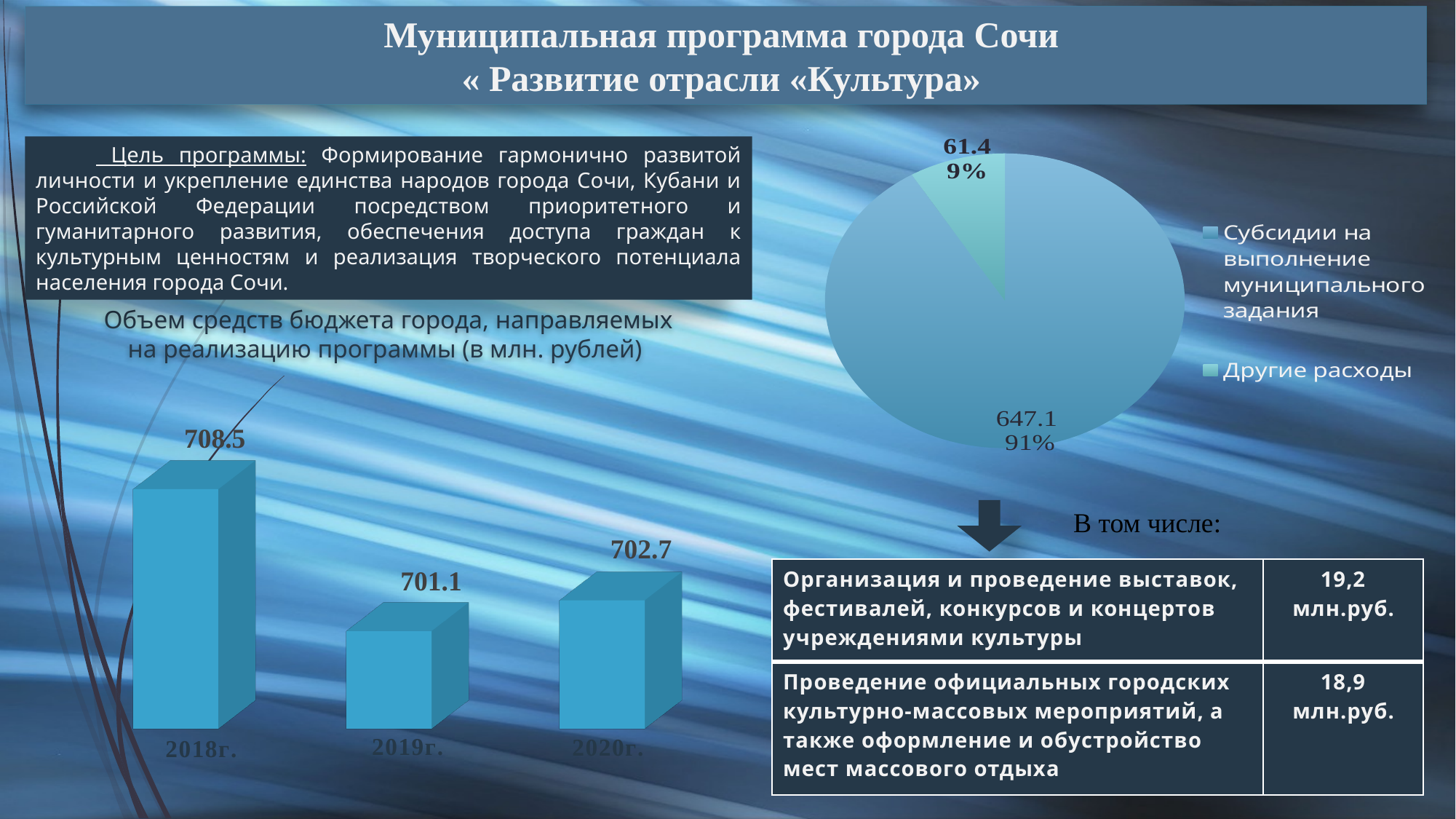
In the bar chart on the left, which year has the lowest value? 2019г. In the bar chart on the left, what is the difference between the values for 2018г. and 2019г.? 7.4 In the pie chart on the right, which slice is larger: Субсидии на выполнение муниципального задания or Другие расходы? Субсидии на выполнение муниципального задания In the pie chart on the right, how many entries does the legend list? 2 In the bar chart on the left, how many years are shown? 3 In the pie chart on the right, what share does Субсидии на выполнение муниципального задания have? 91% What type of chart is shown on the left side of the slide? Bar chart In the bar chart on the left, what is the value for 2018г.? 708.5 In the bar chart on the left, what is the value for 2019г.? 701.1 In the bar chart on the left, which year has the highest value? 2018г. In the bar chart on the left, what is the value for 2020г.? 702.7 In the pie chart on the right, what is the value for Другие расходы? 61.4